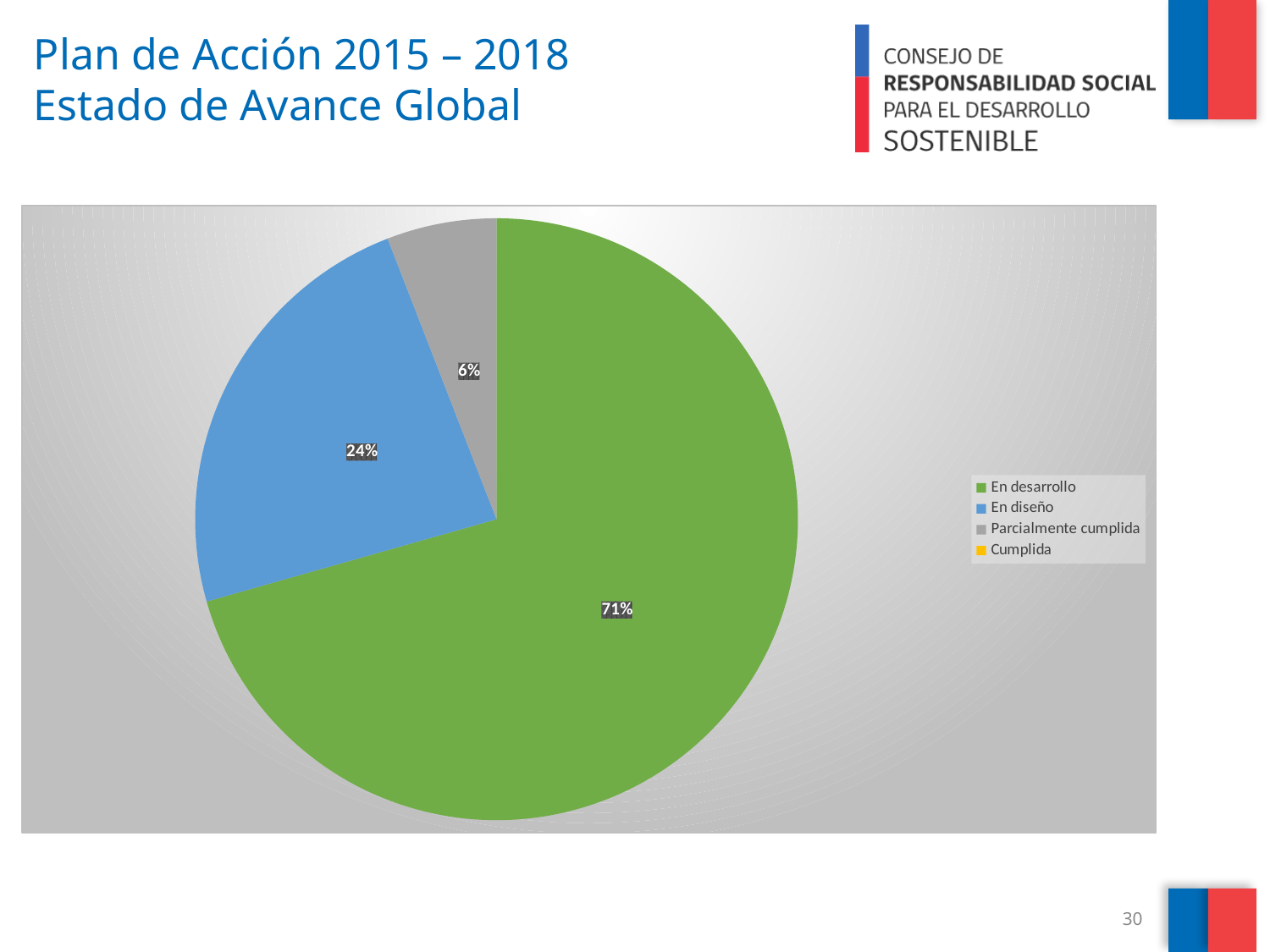
How many entries does the legend list? 4 What percentage of the pie is labelled "En desarrollo"? 71% What colour is the "En diseño" slice? blue What is the combined share of the "En diseño" and "Parcialmente cumplida" slices? 30% Which slice is larger, "En diseño" or "Parcialmente cumplida"? En diseño What percentage of the pie is labelled "Parcialmente cumplida"? 6% What is the difference in percentage points between the "En desarrollo" slice and the "En diseño" slice? 47 What kind of chart is shown on the slide? pie chart Which category has the largest slice of the pie? En desarrollo What percentage of the pie is labelled "En diseño"? 24% Which legend entry has no visible slice in the pie? Cumplida Which category with a visible slice has the smallest share of the pie? Parcialmente cumplida